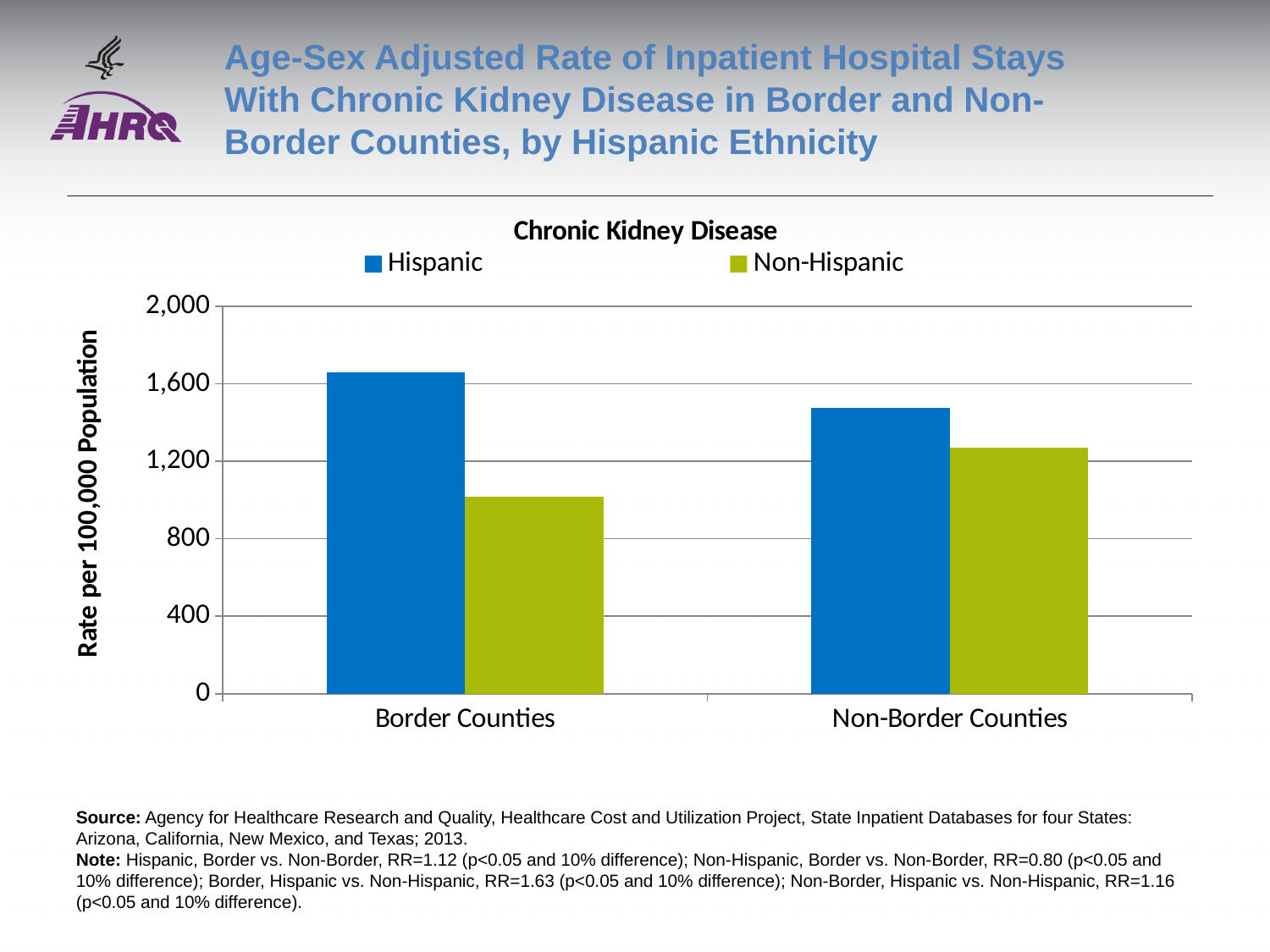
Which is larger: the Hispanic rate in Border Counties or the Hispanic rate in Non-Border Counties? Border Counties Is the Hispanic value for Border Counties greater or less than 1,600? greater How many series does the legend list? 2 Is the Non-Hispanic value for Non-Border Counties greater or less than 1,200? greater Is the Hispanic value for Non-Border Counties greater or less than 1,600? less What kind of chart is shown on the slide? Bar chart How many county categories are shown on the x axis? 2 What is the label on the y axis of the chart? Rate per 100,000 Population Which bar is the lowest in the chart? Non-Hispanic, Border Counties Which is larger: the Non-Hispanic rate in Border Counties or the Non-Hispanic rate in Non-Border Counties? Non-Border Counties Which bar is the highest in the chart? Hispanic, Border Counties